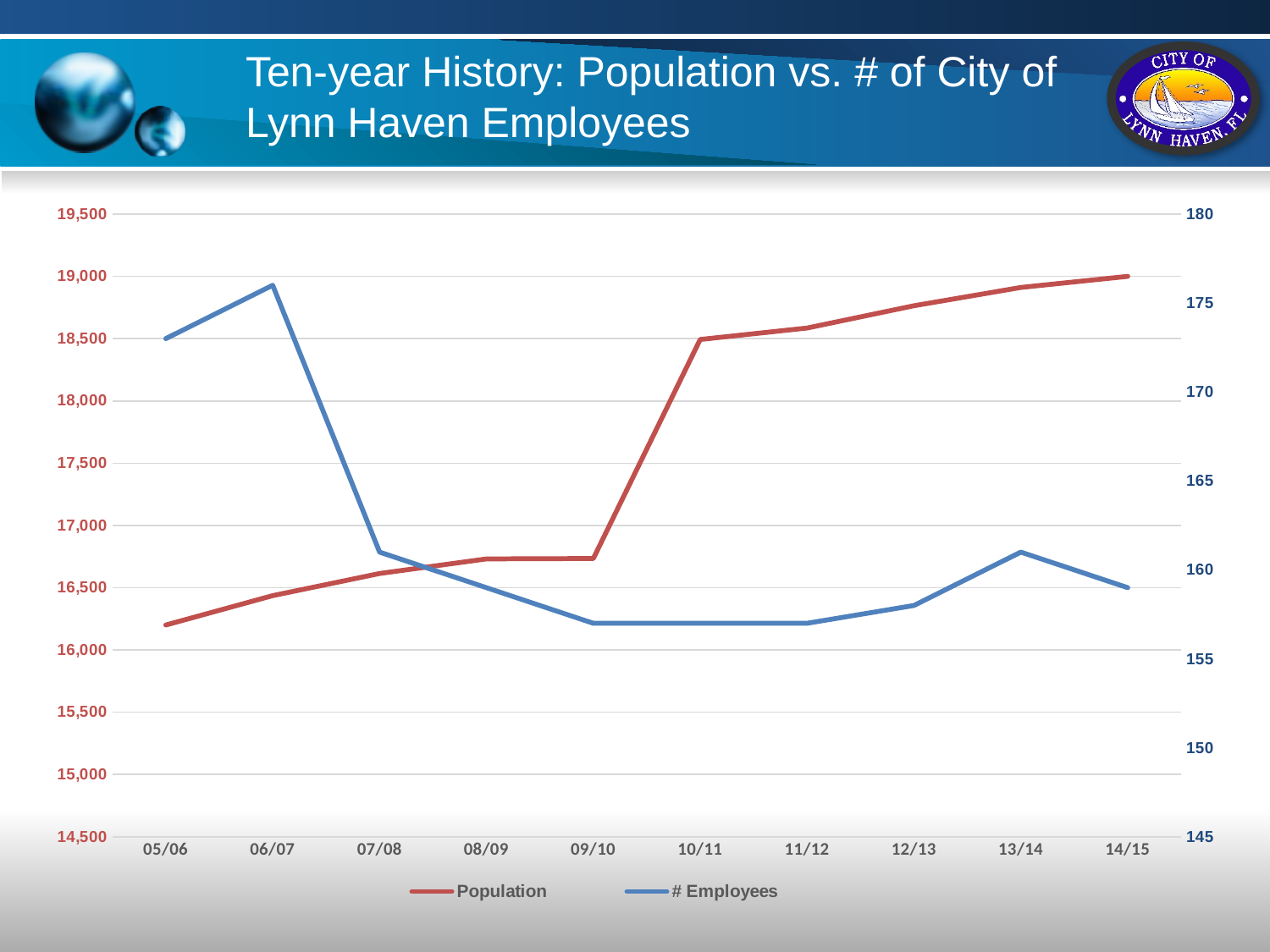
In which year is the Population series at its lowest? 05/06 How many fiscal years are plotted along the x axis? 10 In which year is the Population series at its highest? 14/15 Is the # Employees value for 06/07 greater or less than 170? greater Is the Population value for 10/11 greater or less than 18,000? greater Does the Population series generally rise or fall from 05/06 to 14/15? Rise Is the Population value for 05/06 greater or less than 16,500? less What kind of chart is shown on the slide? Line chart In which year is the # Employees series at its highest? 06/07 How many series does the legend list? 2 Which is larger, the # Employees value for 05/06 or for 13/14? 05/06